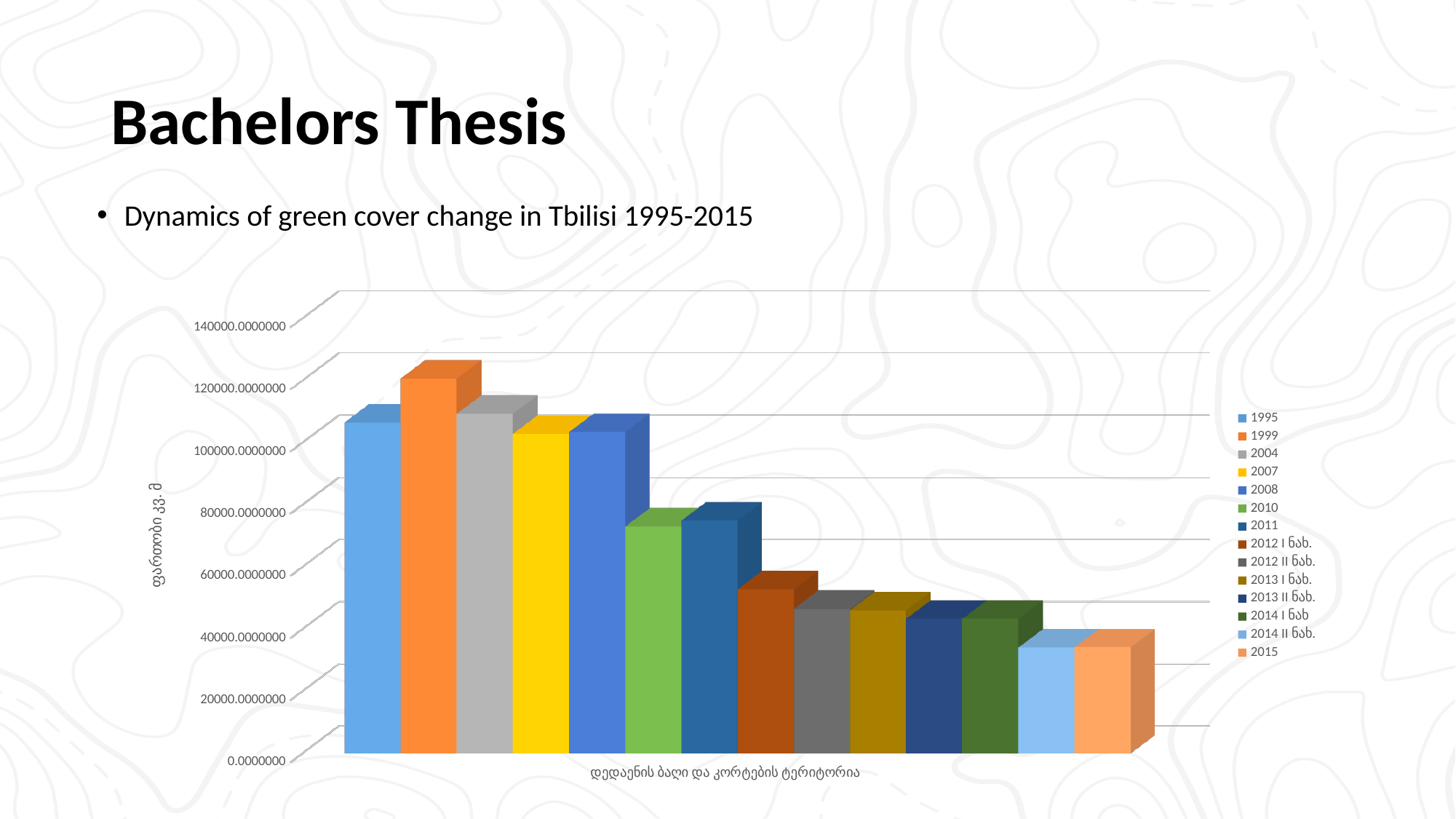
Which is larger, the value for 2010 or the value for 2013 II ნახ.? 2010 Is the value for 2012 I ნახ. greater or less than 60000? less How many series does the legend list? 14 Is the value for 2010 greater or less than 80000? less Which series has the highest value? 1999 Do the values generally rise or fall from the 1995 series to the 2015 series? fall Is the value for 1995 greater or less than 100000? greater Which is larger, the value for 1999 or the value for 2004? 1999 What kind of chart is shown on the slide? bar chart What colour is the bar for the 1999 series? orange